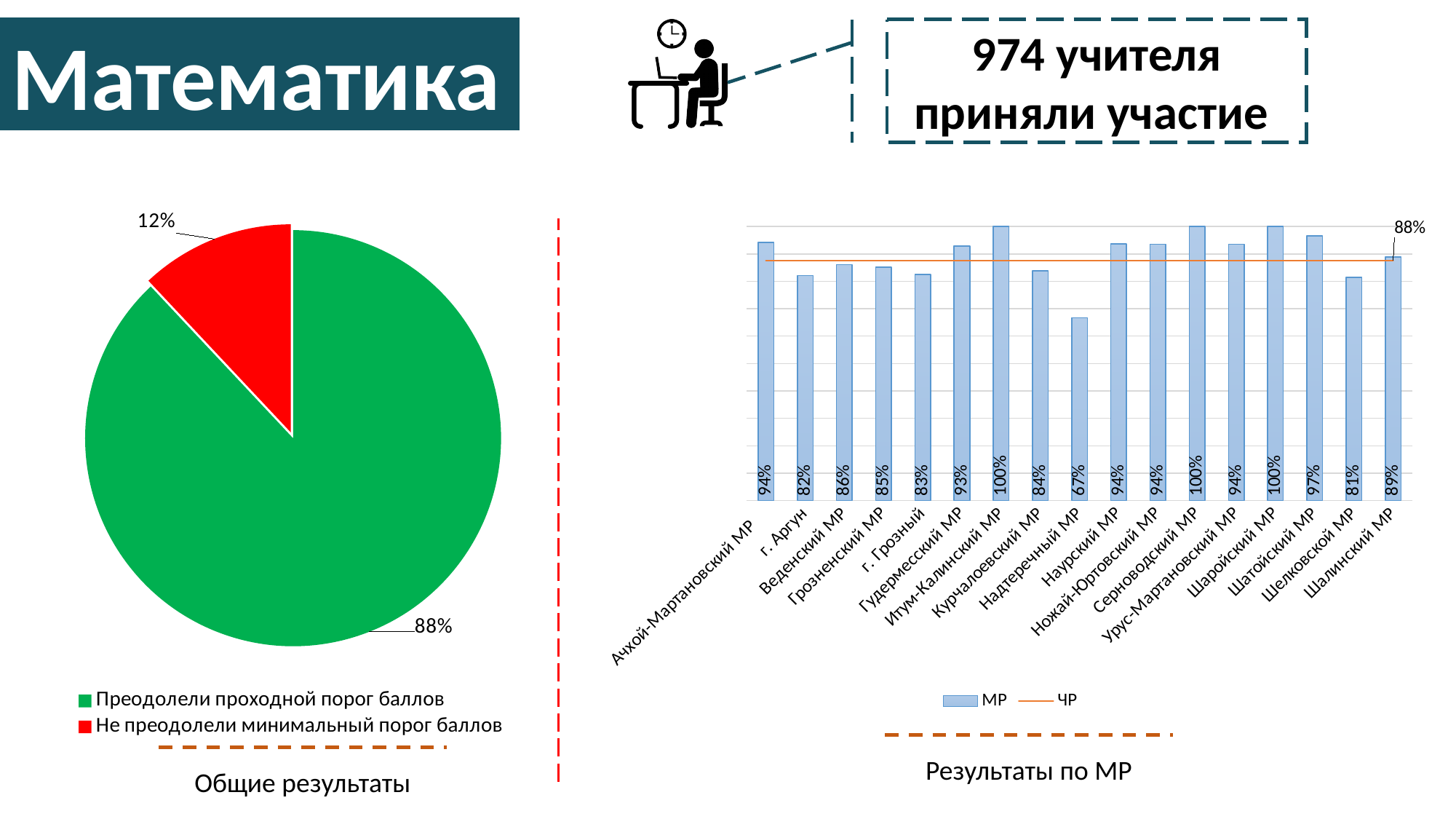
On the pie chart on the left, what share is shown for 'Не преодолели минимальный порог баллов'? 12% On the bar chart 'Результаты по МР', what is the difference between Итум-Калинский МР and г. Аргун? 18% On the pie chart on the left, which colour represents 'Преодолели проходной порог баллов'? Green On the bar chart 'Результаты по МР', which district has the lowest value? Надтеречный МР How many series does the legend of the chart 'Результаты по МР' list? 2 On the bar chart 'Результаты по МР', what is the value for Шатойский МР? 97% On the bar chart 'Результаты по МР', what is the value for Надтеречный МР? 67% How many districts (categories) are shown on the bar chart 'Результаты по МР'? 17 On the bar chart 'Результаты по МР', which is larger: Веденский МР or Шелковской МР? Веденский МР On the pie chart on the left, what share of teachers passed the threshold (Преодолели проходной порог баллов)? 88% On the chart 'Результаты по МР', what value is labelled on the ЧР line? 88% What type of chart is the chart on the left of the slide? Pie chart